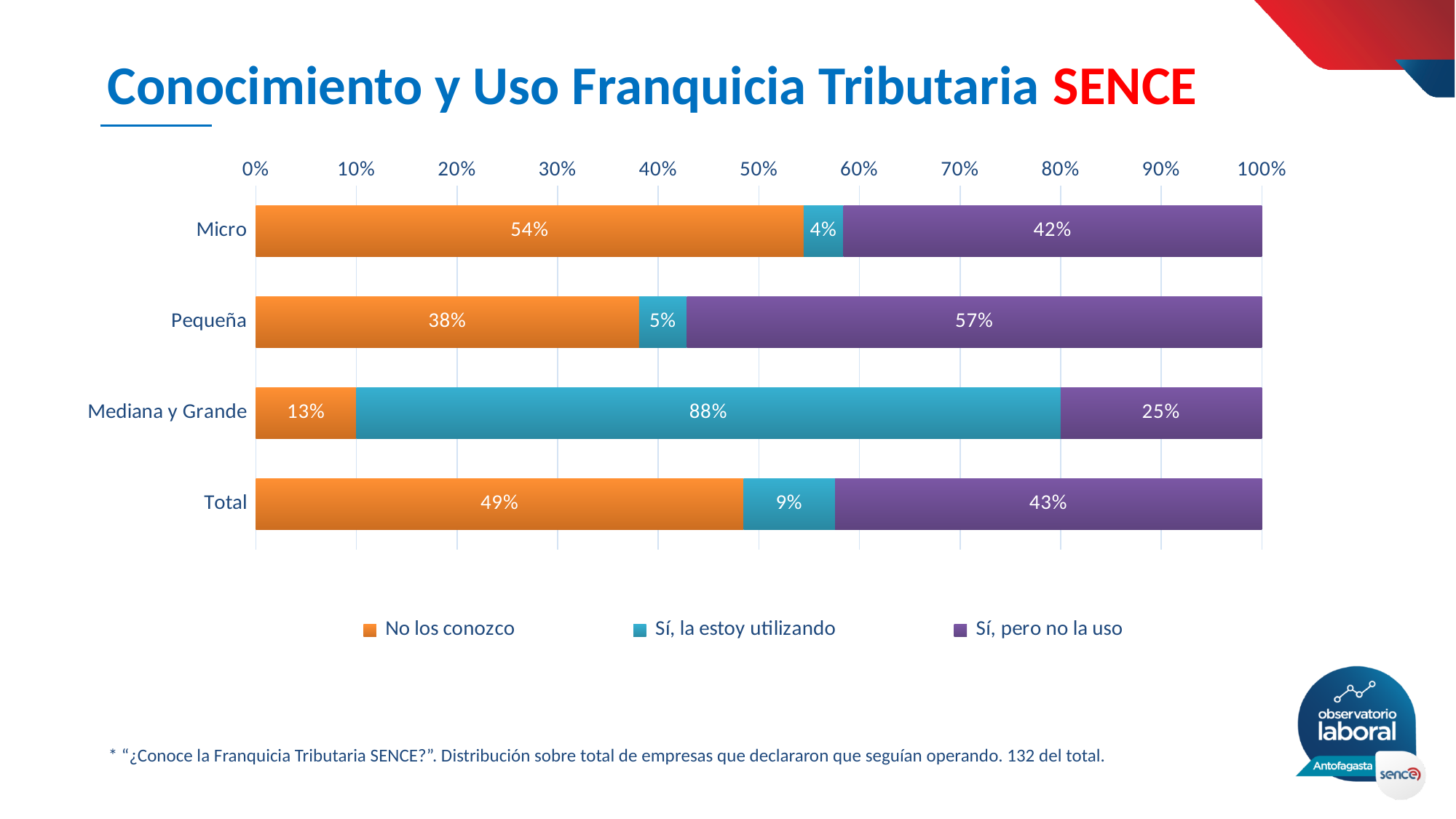
What is the difference between the 'No los conozco' values for Micro and Pequeña? 16% What is the value of 'No los conozco' for Micro? 54% Which category has the highest value for 'No los conozco'? Micro Which category has the lowest value for 'Sí, pero no la uso'? Mediana y Grande What is the value of 'Sí, pero no la uso' for Pequeña? 57% What kind of chart is shown on the slide? Stacked bar chart What is the value of 'Sí, la estoy utilizando' for Mediana y Grande? 88% How many categories are shown on the vertical axis? 4 Which legend entry is shown in orange? No los conozco Which is larger: 'Sí, pero no la uso' for Micro or for Total? Total What is the value of 'Sí, la estoy utilizando' for Total? 9% How many series does the legend list? 3